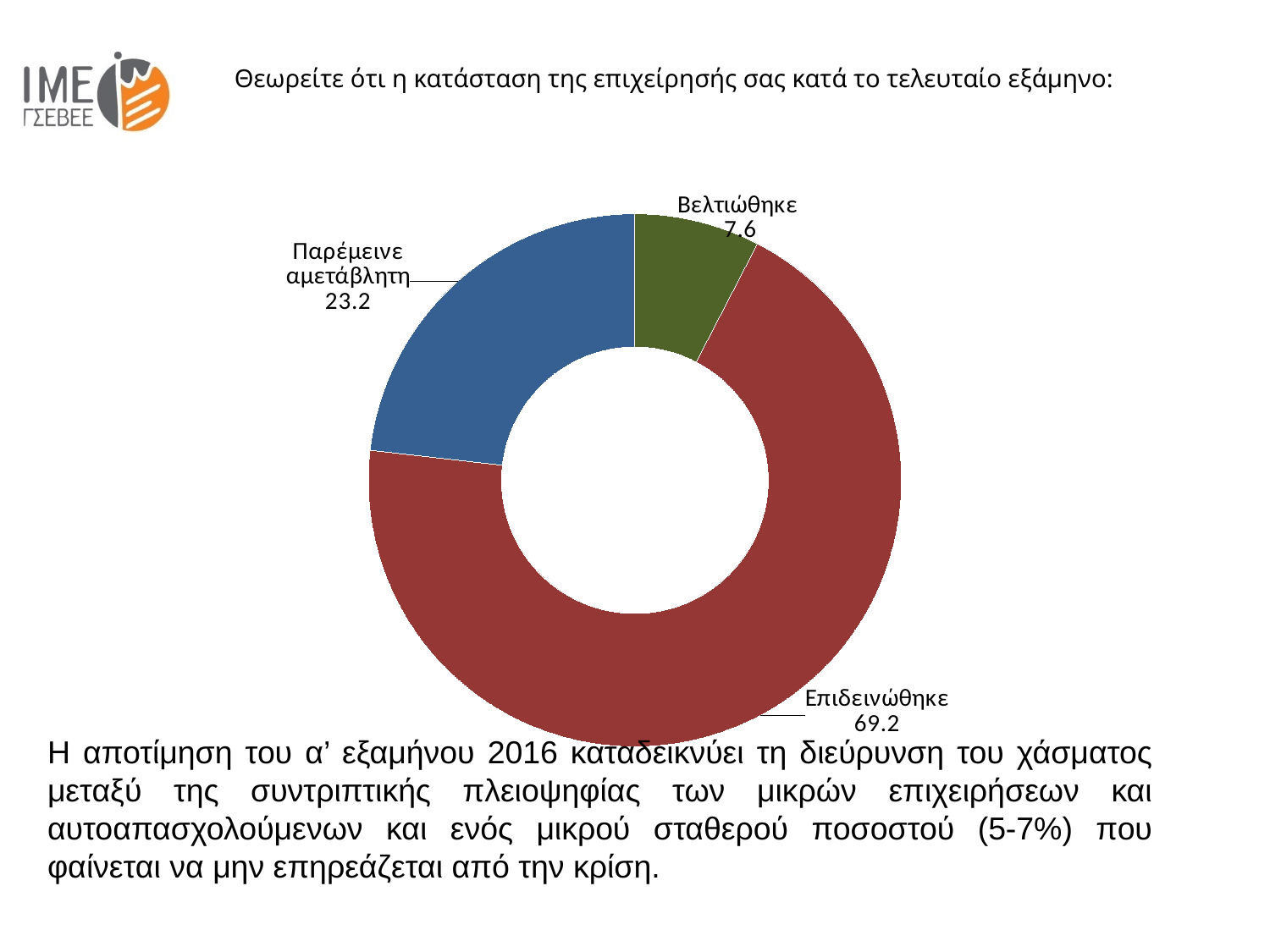
What value is shown for Επιδεινώθηκε? 69.2 What value is shown for Παρέμεινε αμετάβλητη? 23.2 Which is larger, the value for Παρέμεινε αμετάβλητη or the value for Βελτιώθηκε? Παρέμεινε αμετάβλητη What is the difference between the values for Επιδεινώθηκε and Παρέμεινε αμετάβλητη? 46 Which category has the smallest share of the chart? Βελτιώθηκε What is the difference between the values for Παρέμεινε αμετάβλητη and Βελτιώθηκε? 15.6 Which category has the largest share of the chart? Επιδεινώθηκε How many categories are shown in the chart? 3 What kind of chart is shown on the slide? Doughnut (pie) chart What colour is the Επιδεινώθηκε segment? Red What is the total of the three values shown in the chart? 100 What value is shown for Βελτιώθηκε? 7.6